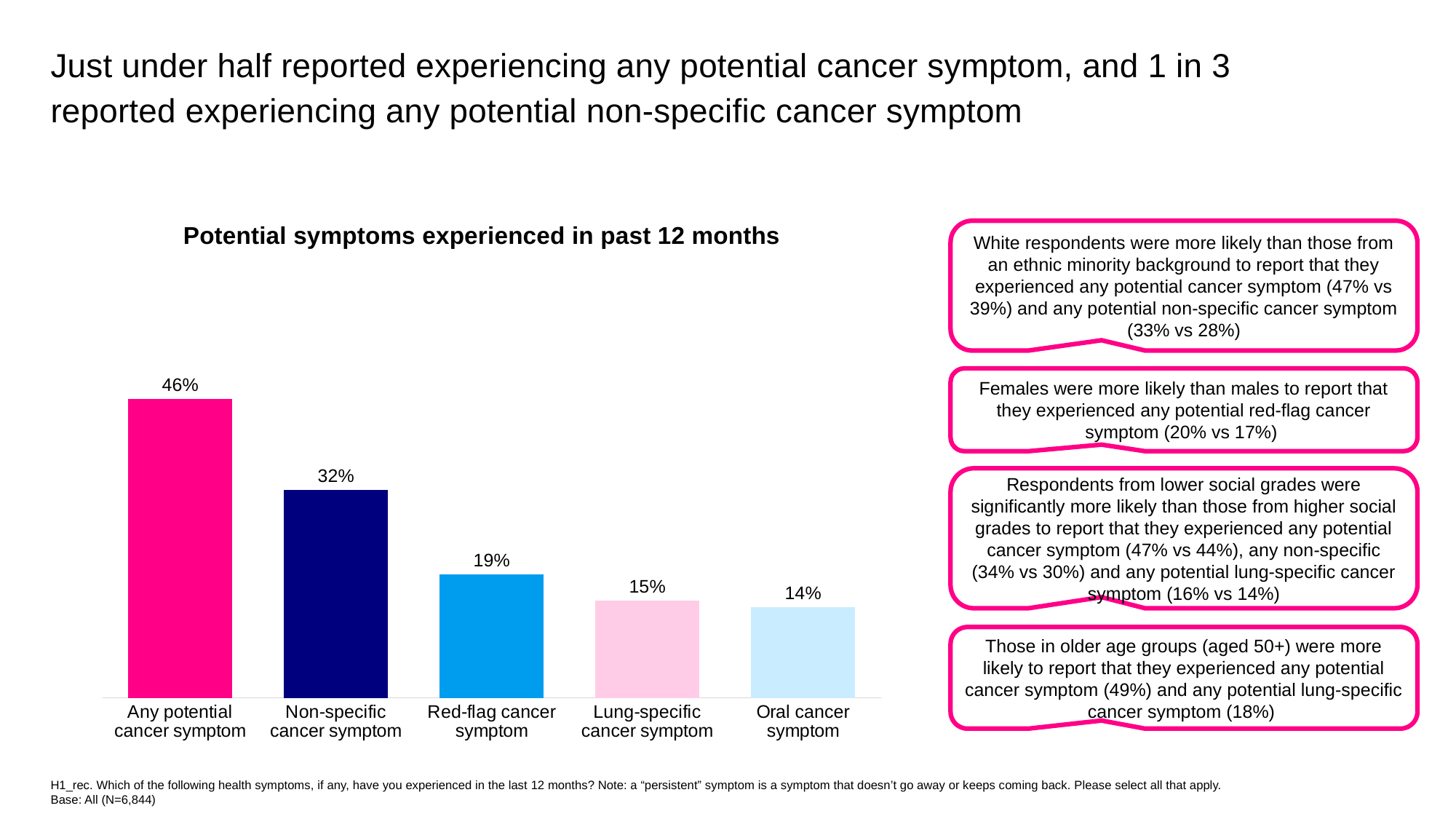
Do the values rise or fall from left to right across the categories? Fall Which is larger: the value for red-flag cancer symptom or lung-specific cancer symptom? Red-flag cancer symptom How many categories are shown in the chart? 5 Which category has the lowest value in the chart? Oral cancer symptom What kind of chart is shown on the slide? Bar chart What is the title of the chart? Potential symptoms experienced in past 12 months What is the difference between the values for any potential cancer symptom and non-specific cancer symptom? 14% What percentage of respondents reported experiencing any potential cancer symptom? 46% What is the value for oral cancer symptom? 14% What percentage reported a red-flag cancer symptom? 19% What is the value shown for non-specific cancer symptom? 32% Which category has the highest value in the chart? Any potential cancer symptom